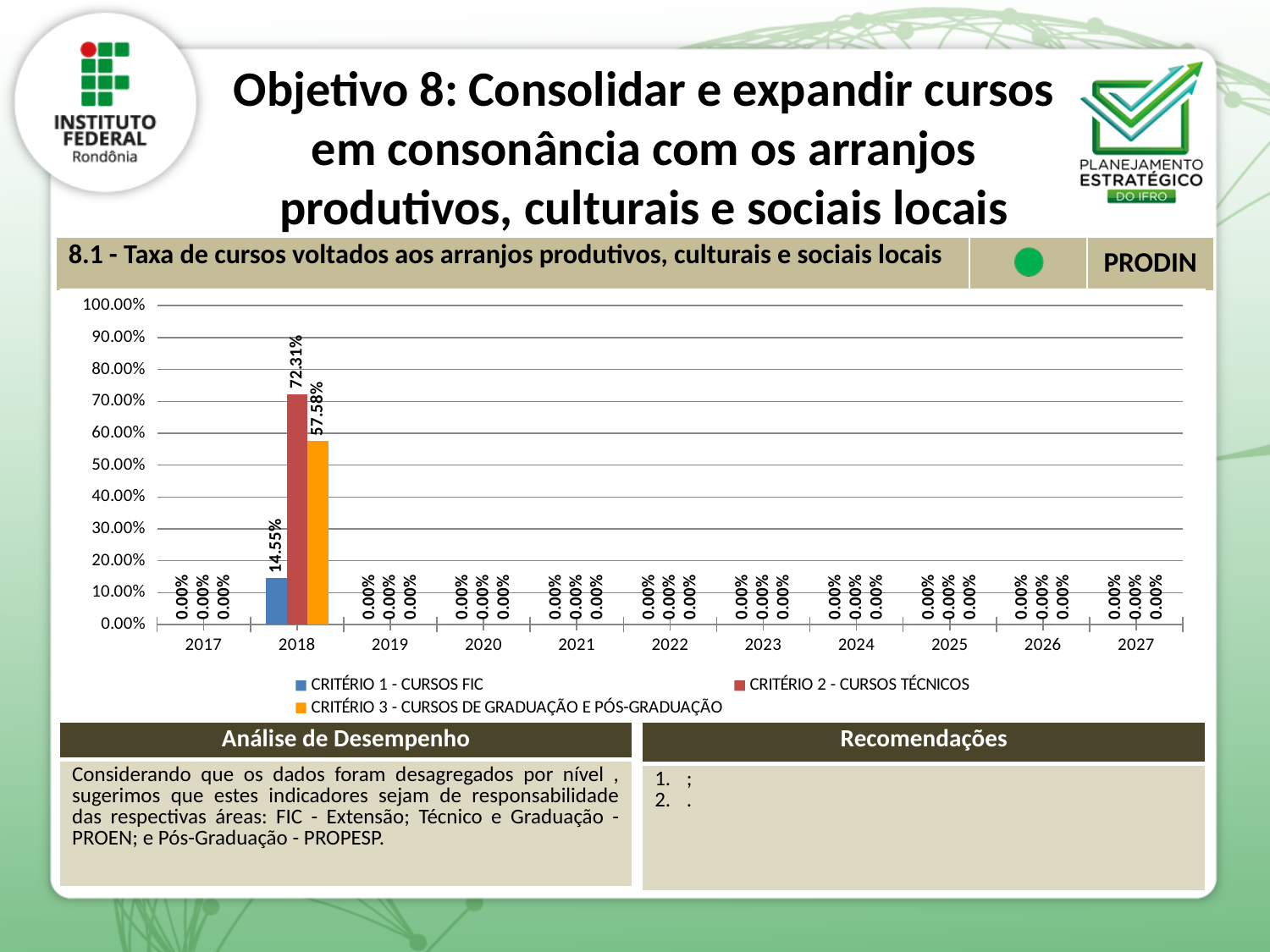
How many years are shown on the x axis of the chart? 11 What is the value for CRITÉRIO 3 - CURSOS DE GRADUAÇÃO E PÓS-GRADUAÇÃO in 2018? 57.58% What is the value for CRITÉRIO 1 - CURSOS FIC in 2018? 14.55% Which series has the lowest value in 2018? CRITÉRIO 1 - CURSOS FIC What is the value for CRITÉRIO 2 - CURSOS TÉCNICOS in 2018? 72.31% How many series does the chart legend list? 3 In 2018, which is larger: CRITÉRIO 1 - CURSOS FIC or CRITÉRIO 3 - CURSOS DE GRADUAÇÃO E PÓS-GRADUAÇÃO? CRITÉRIO 3 - CURSOS DE GRADUAÇÃO E PÓS-GRADUAÇÃO Which series has the highest value in 2018? CRITÉRIO 2 - CURSOS TÉCNICOS What kind of chart is shown on the slide? Bar chart What is the value for CRITÉRIO 2 - CURSOS TÉCNICOS in 2019? 0.00% What is the difference between CRITÉRIO 2 - CURSOS TÉCNICOS and CRITÉRIO 3 - CURSOS DE GRADUAÇÃO E PÓS-GRADUAÇÃO in 2018? 14.73% Is the value for CRITÉRIO 2 - CURSOS TÉCNICOS in 2018 greater or less than 70.00%? greater